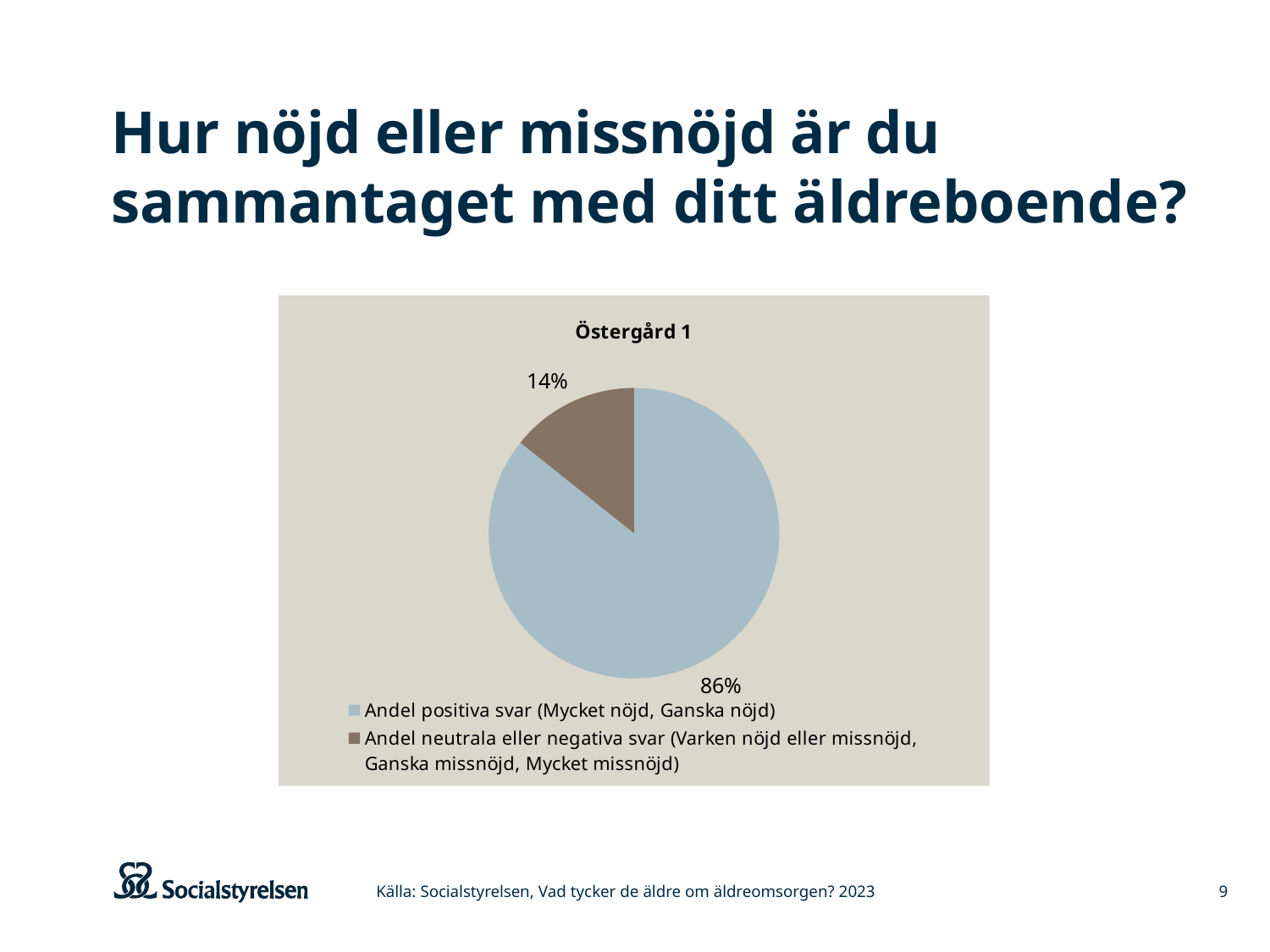
What colour is the slice for 'Andel positiva svar (Mycket nöjd, Ganska nöjd)'? Light blue-grey What share of the pie is 'Andel positiva svar (Mycket nöjd, Ganska nöjd)'? 86% What kind of chart is shown on the slide? Pie chart Which is larger: the share of positive answers or the share of neutral or negative answers? Andel positiva svar (Mycket nöjd, Ganska nöjd) How many entries does the legend list? 2 Which slice of the pie is the smallest? Andel neutrala eller negativa svar (Varken nöjd eller missnöjd, Ganska missnöjd, Mycket missnöjd) How many slices does the pie chart have? 2 What is the title of the chart? Östergård 1 What is the difference in percentage points between the positive-answer slice and the neutral-or-negative slice? 72 percentage points What share of the pie is 'Andel neutrala eller negativa svar (Varken nöjd eller missnöjd, Ganska missnöjd, Mycket missnöjd)'? 14% Which slice of the pie is the largest? Andel positiva svar (Mycket nöjd, Ganska nöjd)